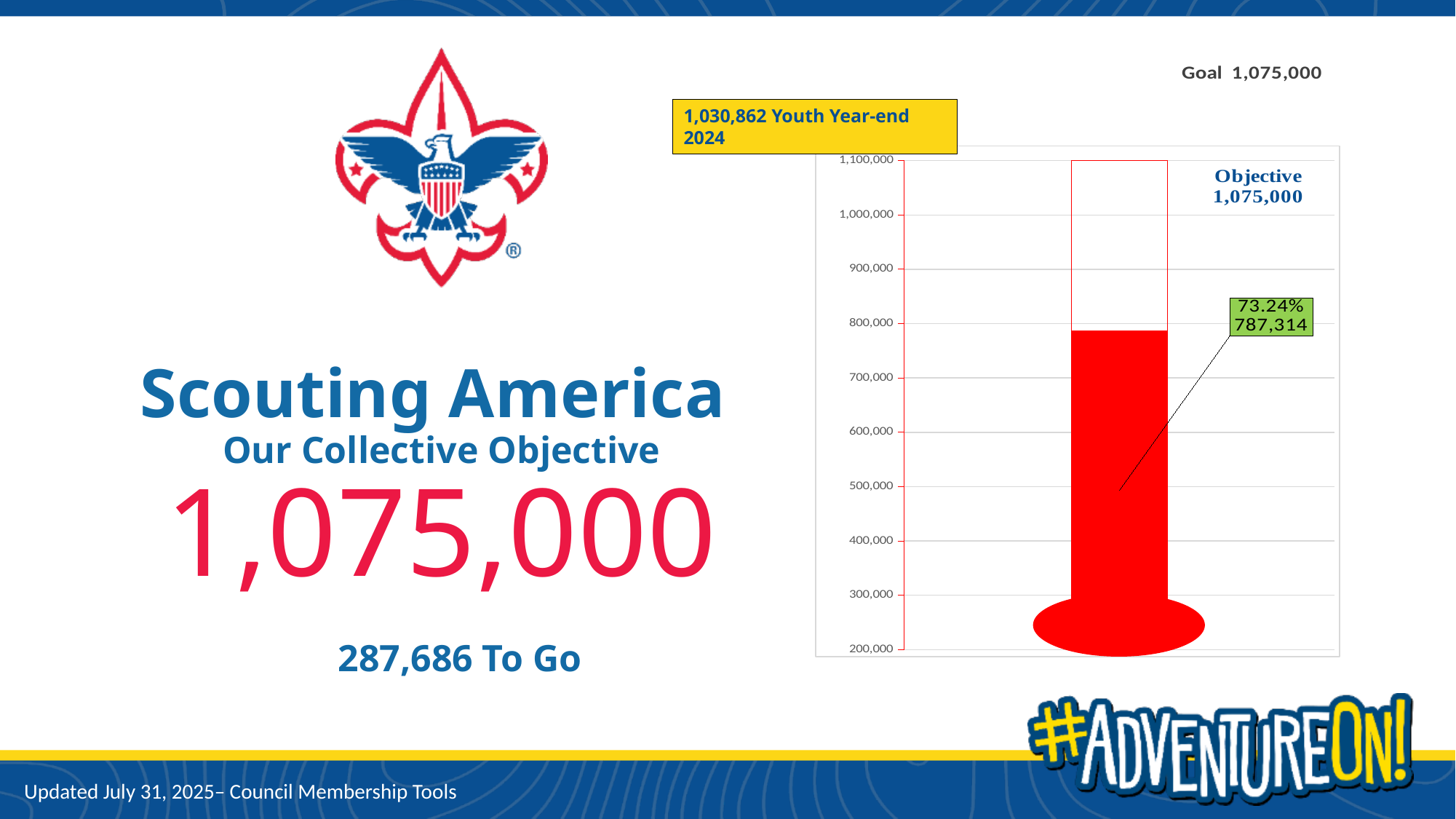
What colour is the filled portion of the thermometer chart? red What kind of chart is shown on the right side of the slide? a thermometer-style bar chart What is the current value shown on the thermometer chart's data label? 787,314 What percentage of the objective has been reached according to the thermometer chart's data label? 73.24% What objective value is printed inside the thermometer chart? 1,075,000 What is the difference between the objective of 1,075,000 and the current value of 787,314 shown on the chart? 287,686 Is the filled level of the thermometer chart greater or less than 700,000? greater Which is larger on the thermometer chart: the current value of 787,314 or the objective of 1,075,000? the objective of 1,075,000 What is the lowest value shown on the thermometer chart's vertical axis? 200,000 What youth year-end 2024 figure is shown in the yellow box above the chart? 1,030,862 Is the filled level of the thermometer chart greater or less than 800,000? less What is the highest value shown on the thermometer chart's vertical axis? 1,100,000